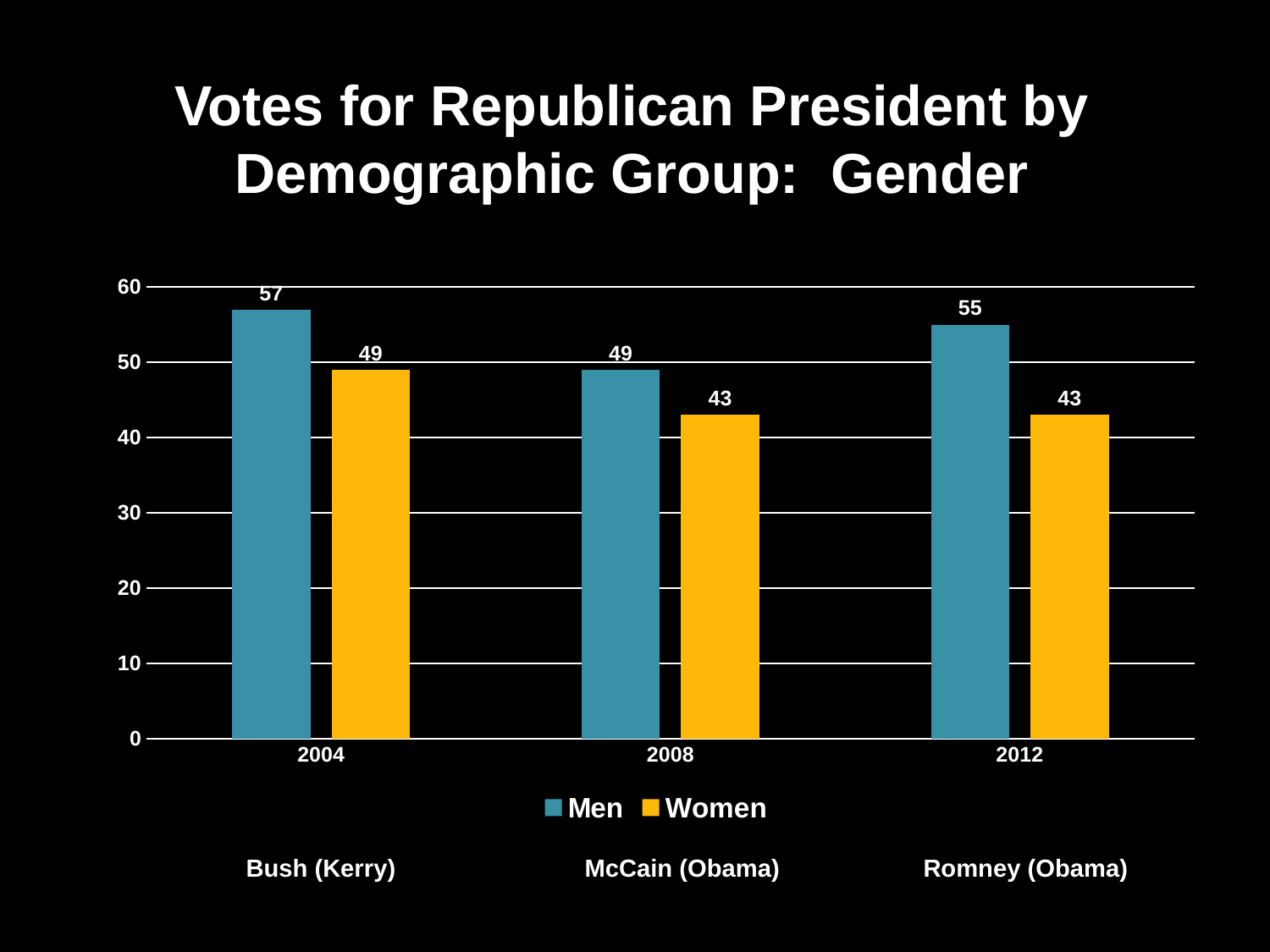
In which year is the value for Men highest? 2004 What kind of chart is shown on the slide? Bar chart What is the value for Women in 2008? 43 What is the value for Women in 2004? 49 What is the difference between the Men values in 2004 and 2008? 8 What is the difference between the Men and Women values in 2012? 12 What is the value for Men in 2012? 55 Which is larger in 2008, the value for Men or the value for Women? Men What is the value for Men in 2004? 57 How many years are shown on the x axis? 3 In which year is the value for Men lowest? 2008 How many series does the legend list? 2